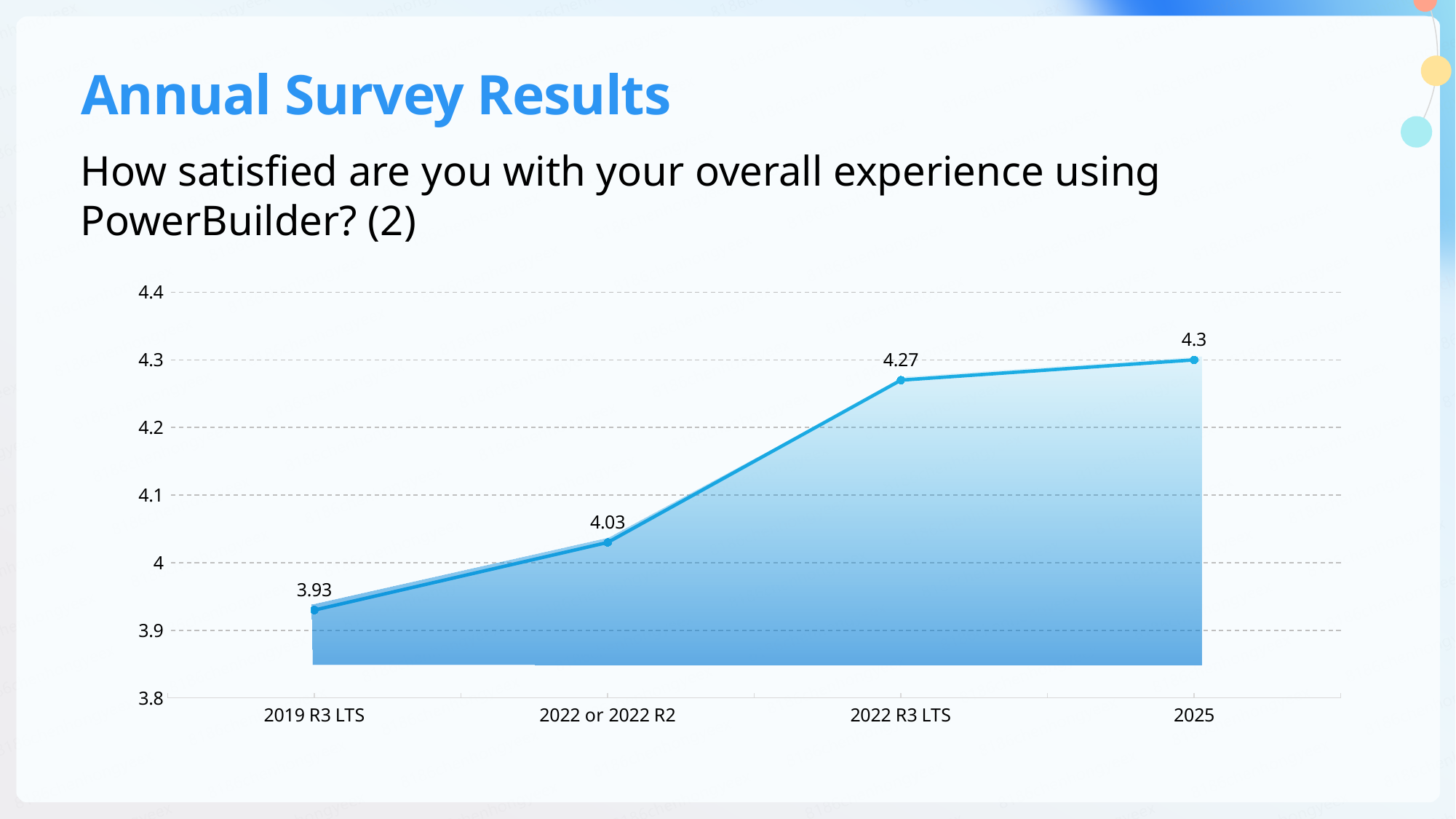
How many categories are shown on the x axis? 4 What is the satisfaction value for 2025? 4.3 What is the satisfaction value for 2022 or 2022 R2? 4.03 Which category has the lowest satisfaction value? 2019 R3 LTS What is the difference between the values for 2025 and 2019 R3 LTS? 0.37 Do the values rise or fall from 2019 R3 LTS to 2025? rise Is the value for 2019 R3 LTS greater or less than 4? less Which category has the highest satisfaction value? 2025 What is the difference between the values for 2022 R3 LTS and 2022 or 2022 R2? 0.24 Which is larger, the value for 2022 or 2022 R2 or the value for 2022 R3 LTS? 2022 R3 LTS What is the satisfaction value for 2022 R3 LTS? 4.27 What is the satisfaction value for 2019 R3 LTS? 3.93